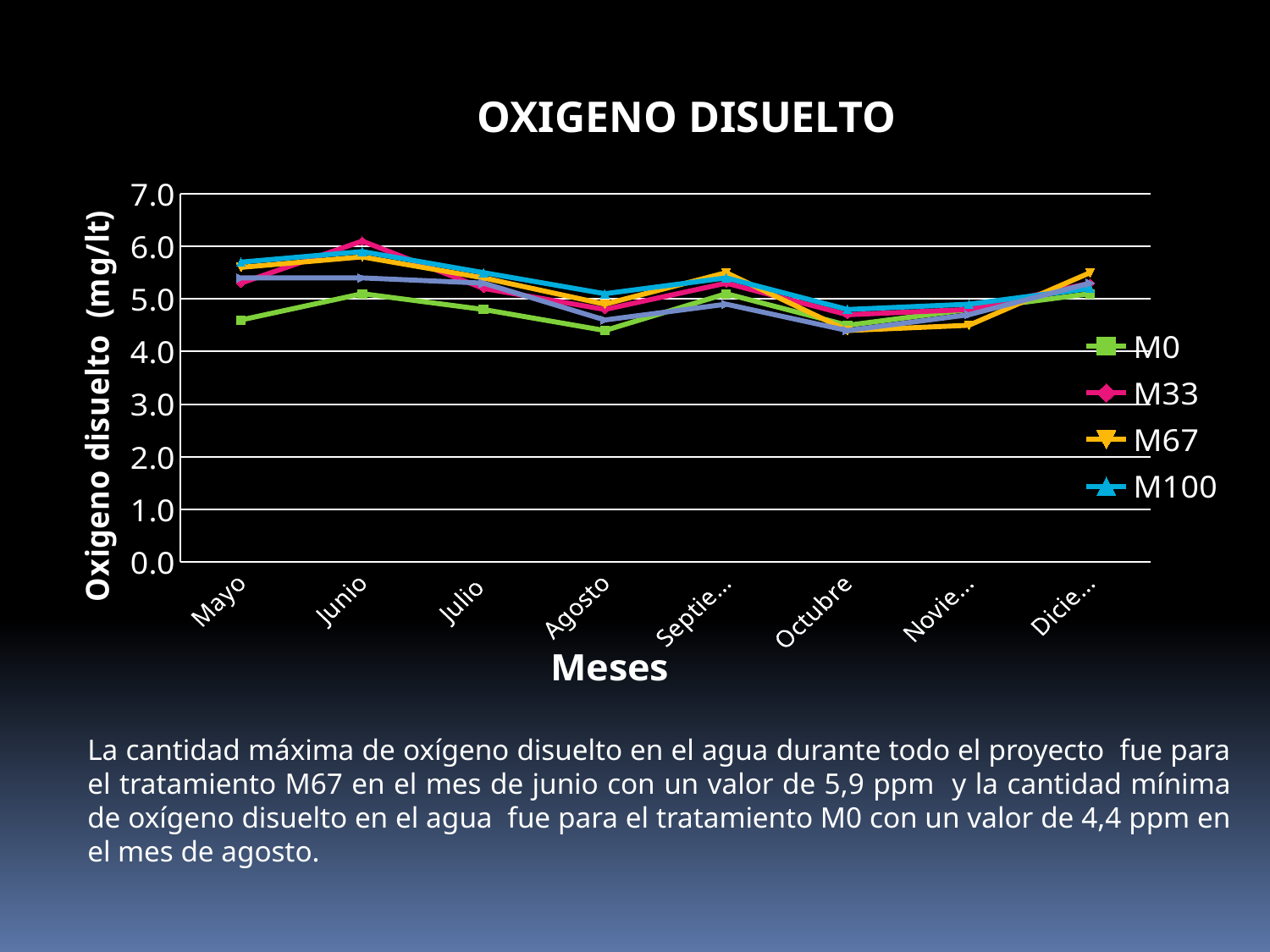
What kind of chart is shown on the slide? line chart What is the title of the chart? OXIGENO DISUELTO How many series does the chart legend list? 4 Is the value for M33 in Junio greater or less than 5.0? greater How many months are shown along the x axis of the chart? 8 Which series has the lowest value in Mayo? M0 Is the value for M100 in Mayo greater or less than 5.0? greater Does the M0 line rise or fall from Junio to Agosto? fall What is the label of the y axis? Oxigeno disuelto (mg/lt) In Mayo, which is larger, the value for M0 or the value for M100? M100 Is the value for M0 in Mayo greater or less than 5.0? less